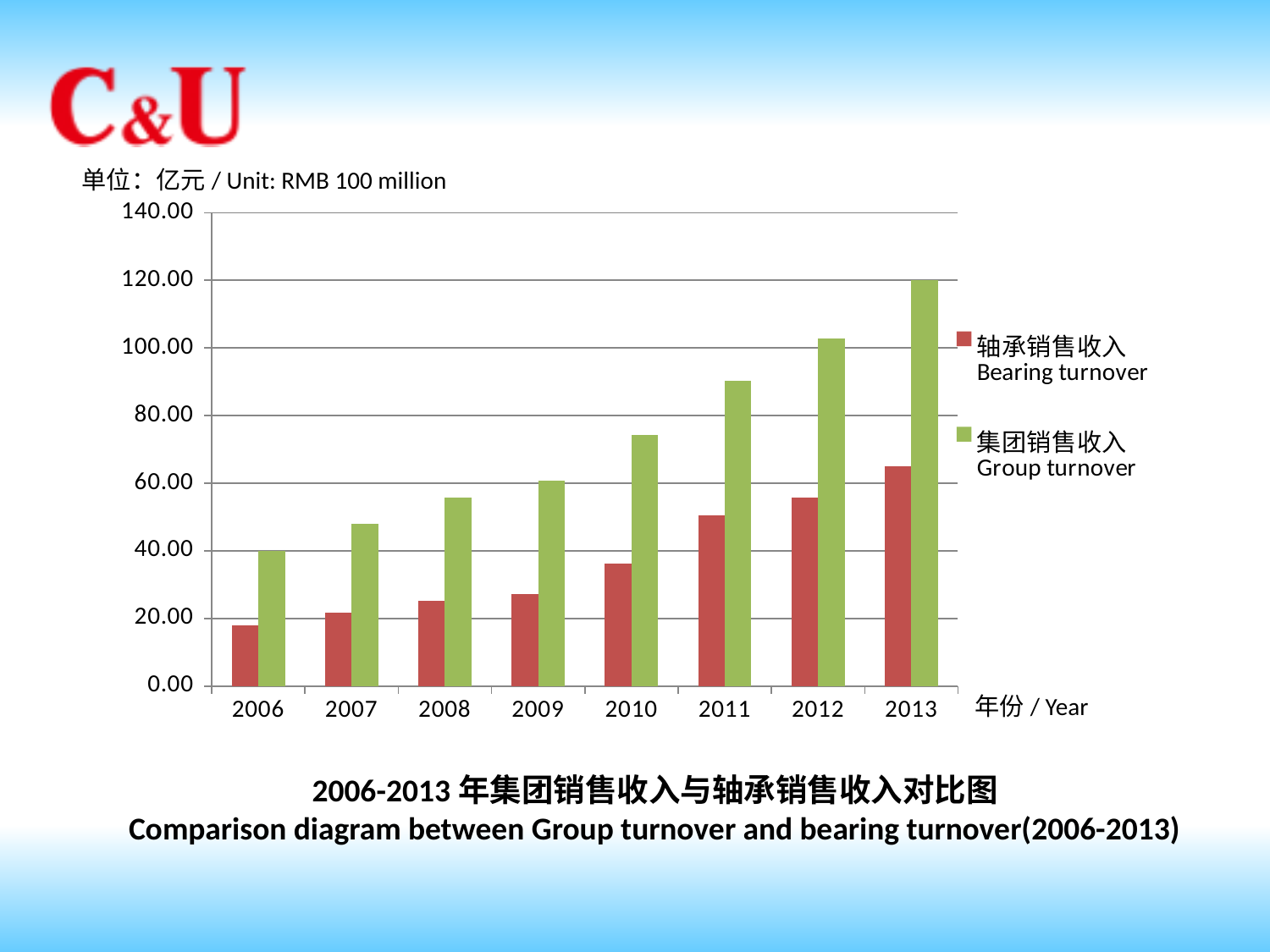
What kind of chart is shown on the slide? Bar chart In 2013, which is larger: Group turnover or Bearing turnover? Group turnover Does Group turnover rise or fall from 2006 to 2013? Rise What unit is stated for the values in the chart? RMB 100 million Is the Bearing turnover for 2013 greater or less than 60? greater Is the Group turnover for 2013 greater or less than 100? greater Is the Group turnover for 2011 greater or less than 80? greater In which year is Group turnover highest? 2013 How many series does the chart's legend list? 2 How many years are shown on the x axis of the chart? 8 In which year is Bearing turnover lowest? 2006